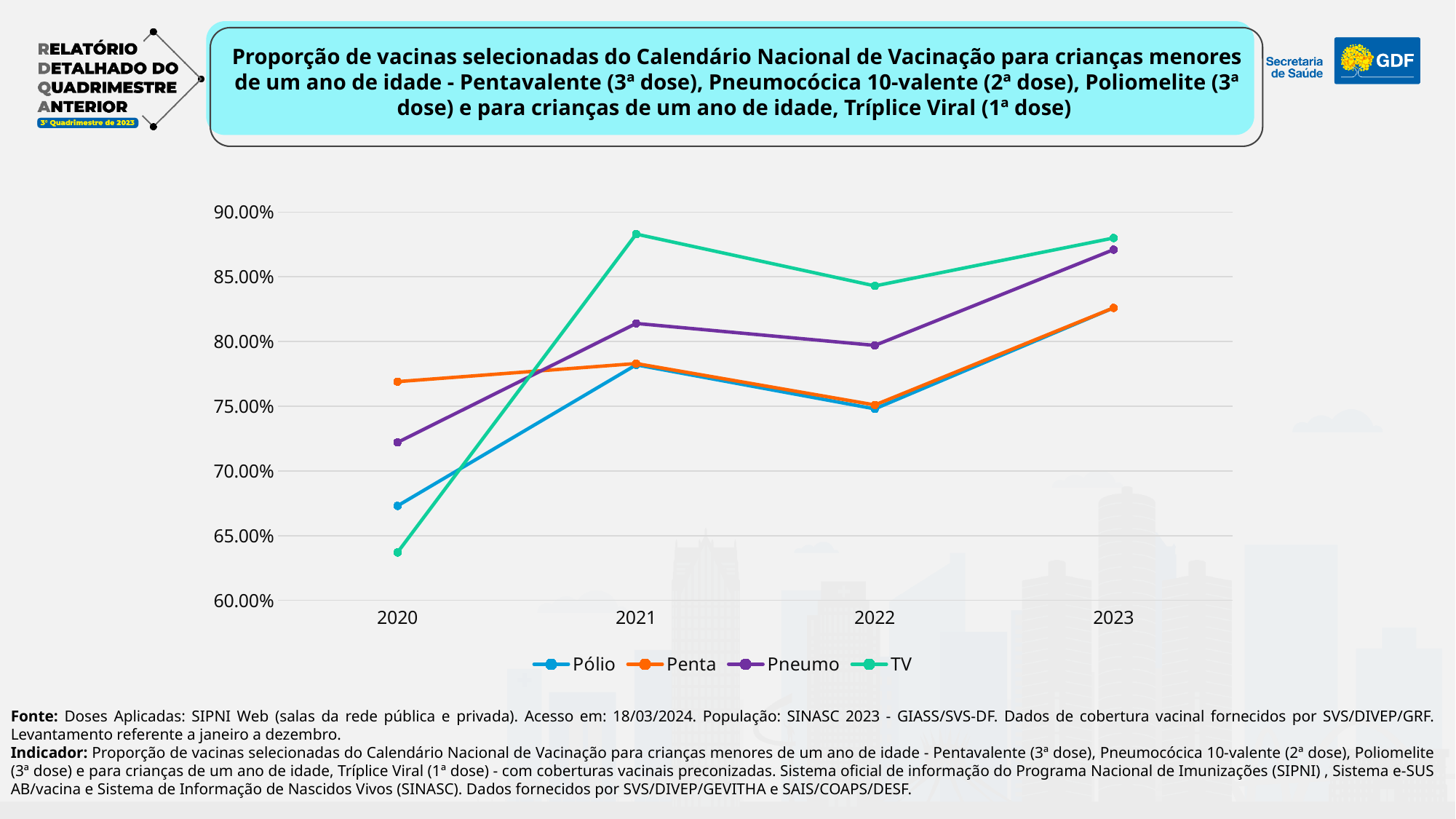
Which is larger in 2022, the value for Pneumo or the value for Penta? Pneumo Which series has the highest value in 2021? TV How many series does the legend list? 4 What kind of chart is shown on the slide? line chart Which series is drawn in orange? Penta Which series has the lowest value in 2020? TV Which series has the highest value in 2020? Penta Does the TV series rise or fall from 2020 to 2021? rise Is the value for TV in 2020 greater or less than 65.00%? less Is the value for Pólio in 2020 greater or less than 70.00%? less Is the value for Pneumo in 2023 greater or less than 85.00%? greater How many years are shown on the x axis? 4